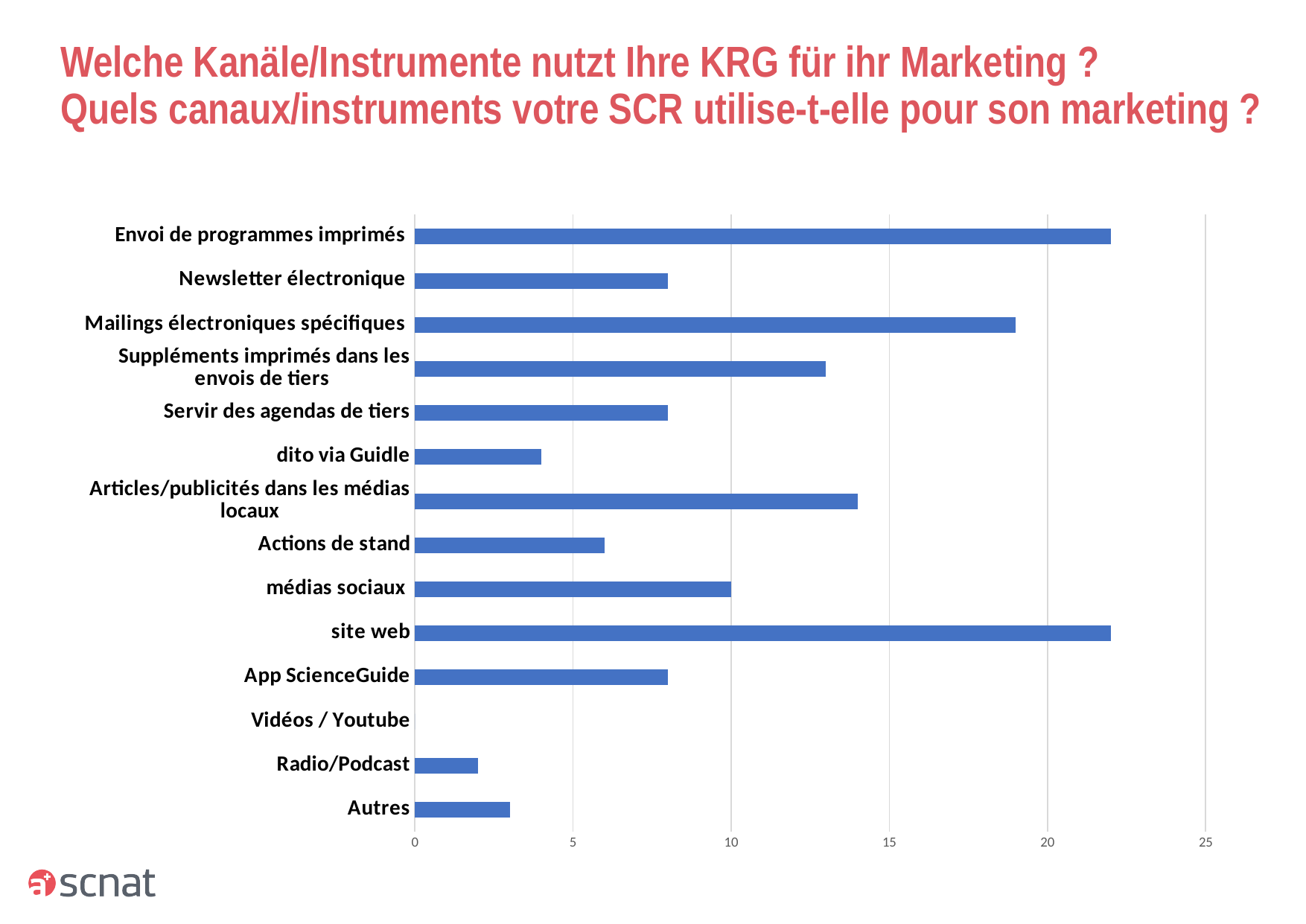
Which is larger, the value for Mailings électroniques spécifiques or the value for Newsletter électronique? Mailings électroniques spécifiques What kind of chart is shown on the slide? bar chart How many categories are plotted in the chart? 14 Is the value for Radio/Podcast greater or less than 5? less Which category has the lowest value in the chart? Vidéos / Youtube Is the value for Suppléments imprimés dans les envois de tiers greater or less than 10? greater Is the value for Newsletter électronique greater or less than 10? less Which is larger, the value for Articles/publicités dans les médias locaux or the value for Actions de stand? Articles/publicités dans les médias locaux What is the highest value shown on the horizontal axis of the chart? 25 What is the value for médias sociaux? 10